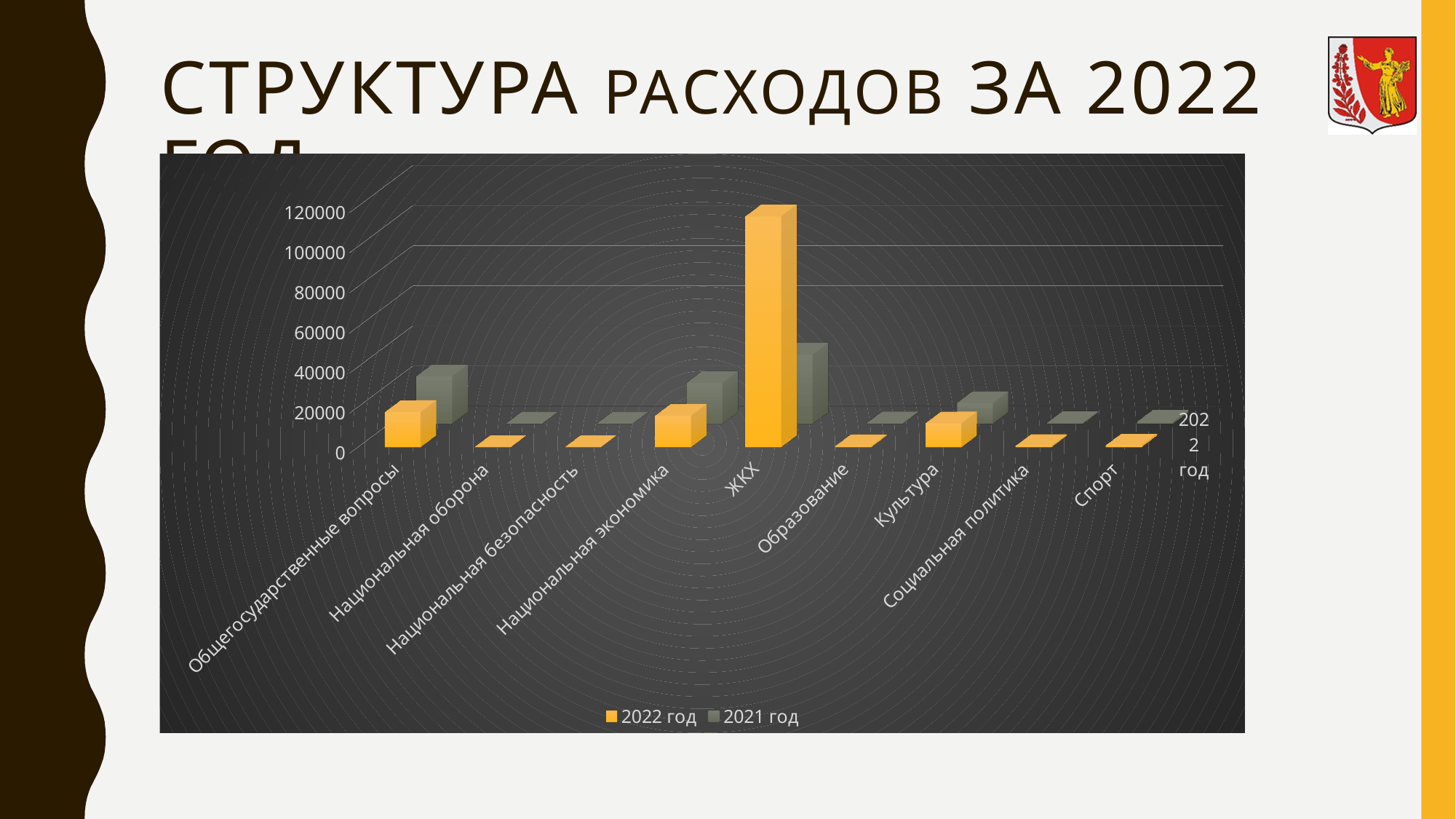
How many categories are shown on the x axis of the chart? 9 Which category has the highest value for the 2022 год series? ЖКХ Is the 2021 год value for ЖКХ greater or less than 80000? less Which category has the highest value for the 2021 год series? ЖКХ Is the 2022 год value for Общегосударственные вопросы greater or less than 40000? less For ЖКХ, which series has the larger value, 2022 год or 2021 год? 2022 год What are the two entries listed in the chart legend? 2022 год and 2021 год For Общегосударственные вопросы, which series has the larger value, 2022 год or 2021 год? 2021 год What colour are the bars for the 2022 год series? orange What kind of chart is shown on the slide? bar chart How many series does the legend list? 2 Is the 2022 год value for ЖКХ greater or less than 80000? greater